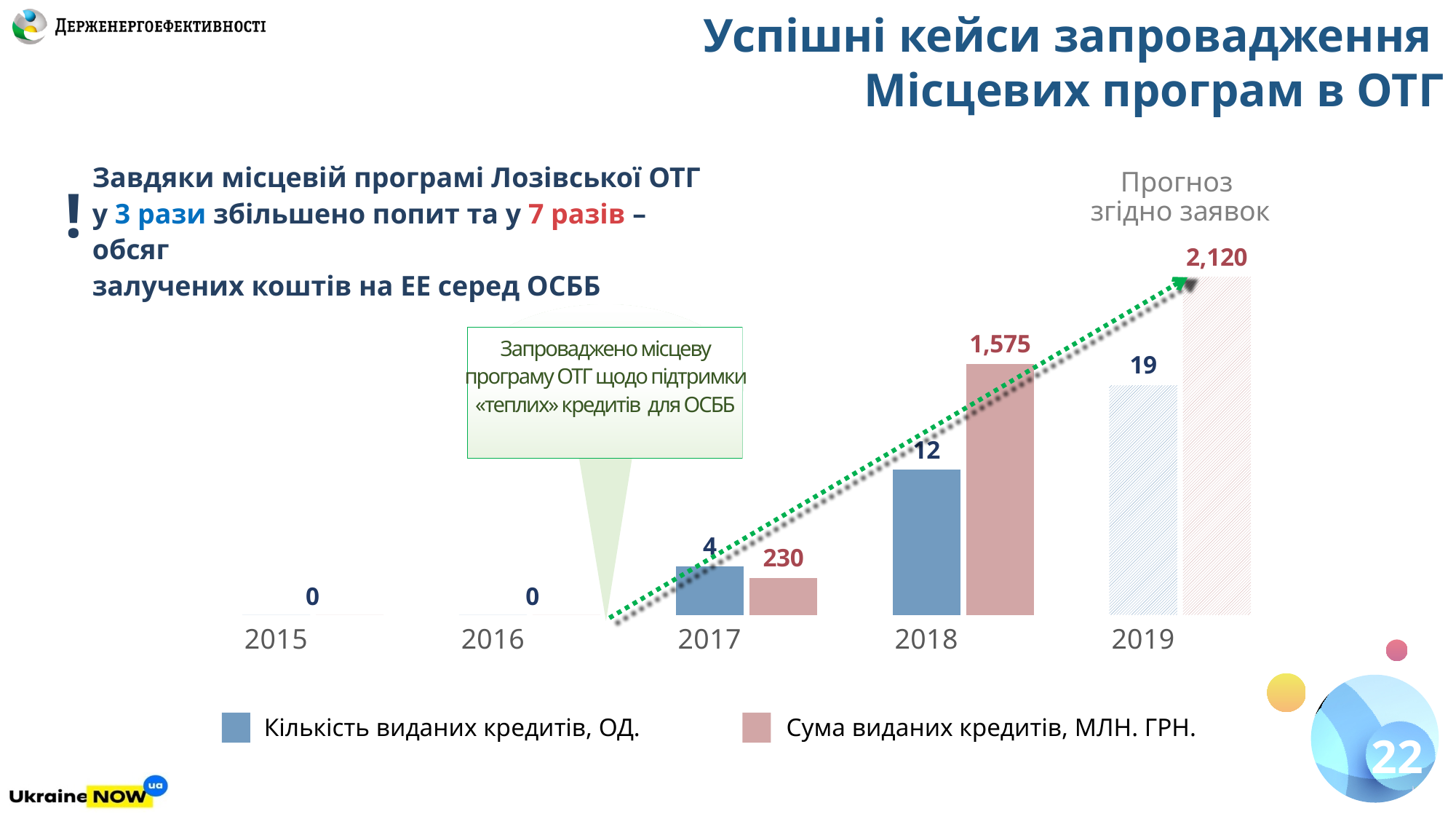
What is the difference between the sum of loans issued in 2018 and in 2017 (МЛН. ГРН.)? 1,345 How many series does the chart legend list? 2 Do the values for the number of loans issued rise or fall from 2017 to 2019? rise What is the forecast sum of loans issued (Сума виданих кредитів, МЛН. ГРН.) for 2019? 2,120 Which is larger: the number of loans issued in 2018 or in 2017? 2018 What is the number of loans issued (Кількість виданих кредитів, ОД.) in 2017? 4 What is the sum of loans issued (Сума виданих кредитів, МЛН. ГРН.) in 2017? 230 What kind of chart is shown on the slide? bar chart Which year has the highest sum of loans issued (Сума виданих кредитів, МЛН. ГРН.)? 2019 What is the difference between the number of loans issued in 2019 and in 2018? 7 How many years are shown on the x axis of the chart? 5 What is the number of loans issued (Кількість виданих кредитів, ОД.) in 2018? 12